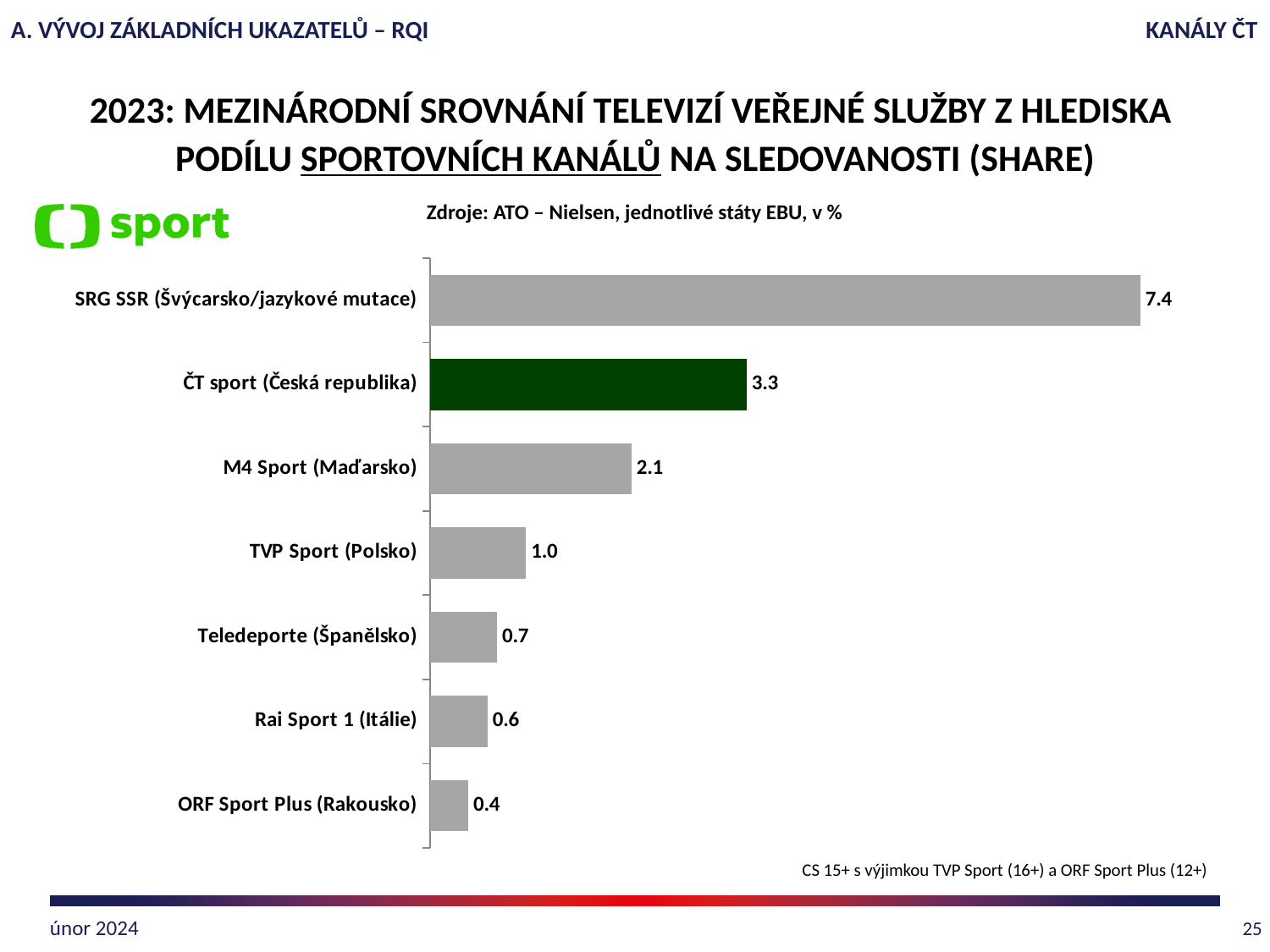
What is the difference between the values for SRG SSR (Švýcarsko/jazykové mutace) and ČT sport (Česká republika)? 4.1 What is the difference between the values for TVP Sport (Polsko) and Teledeporte (Španělsko)? 0.3 What is the value for M4 Sport (Maďarsko)? 2.1 What kind of chart is shown on the slide? bar chart Which channel has the lowest share? ORF Sport Plus (Rakousko) What is the value for ČT sport (Česká republika)? 3.3 What is the value for ORF Sport Plus (Rakousko)? 0.4 Which channel has the highest share? SRG SSR (Švýcarsko/jazykové mutace) Which bar is coloured dark green instead of grey? ČT sport (Česká republika) What is the value for Rai Sport 1 (Itálie)? 0.6 How many channels are shown in the chart? 7 Which is larger, the value for M4 Sport (Maďarsko) or the value for TVP Sport (Polsko)? M4 Sport (Maďarsko)